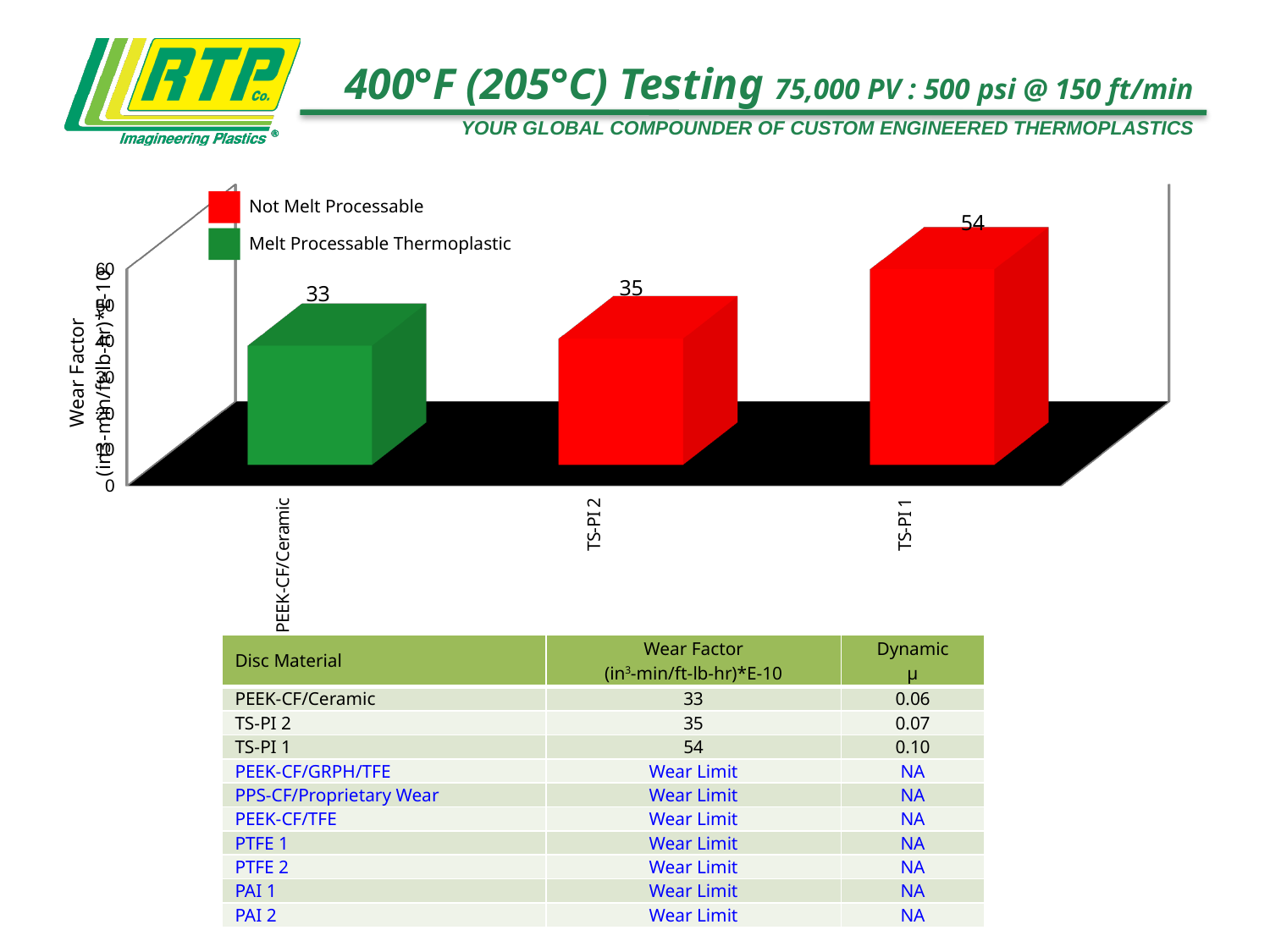
Which legend category is shown in green? Melt Processable Thermoplastic What is the wear factor value shown for TS-PI 1? 54 What kind of chart is shown on the slide? Bar chart How many materials are plotted as bars in the chart? 3 What is the difference between the wear factor of TS-PI 1 and TS-PI 2? 19 What is the difference between the wear factor of TS-PI 2 and PEEK-CF/Ceramic? 2 How many entries does the chart legend list? 2 Which has a larger wear factor, TS-PI 1 or PEEK-CF/Ceramic? TS-PI 1 Which material has the lowest wear factor in the chart? PEEK-CF/Ceramic What is the wear factor value shown for PEEK-CF/Ceramic? 33 Which material has the highest wear factor in the chart? TS-PI 1 What is the wear factor value shown for TS-PI 2? 35